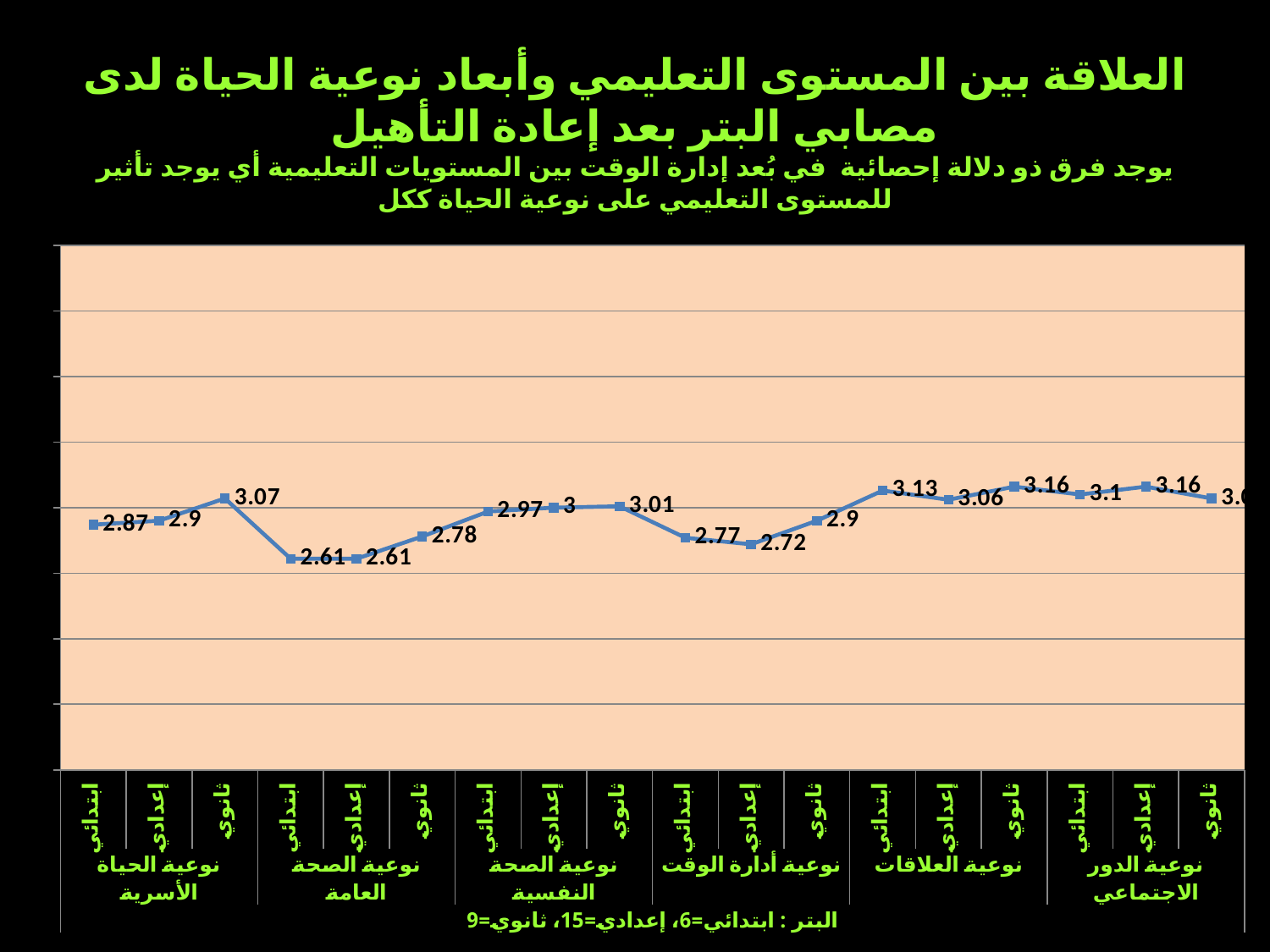
What is the value for ثانوي in the نوعية الحياة الأسرية group? 3.07 Which education level has the lowest value in the نوعية أدارة الوقت group? إعدادي What kind of chart is shown on the slide? line chart How many data points are plotted on the line? 18 What is the value for ابتدائي in the نوعية الصحة العامة group? 2.61 What is the value for ابتدائي in the نوعية العلاقات group? 3.13 Do the values rise or fall from ابتدائي to ثانوي within the نوعية الصحة النفسية group? rise What is the value for إعدادي in the نوعية الصحة النفسية group? 3 What is the difference between the ثانوي value and the ابتدائي value in the نوعية الصحة العامة group? 0.17 What is the value for إعدادي in the نوعية أدارة الوقت group? 2.72 Which is larger: the ابتدائي value in نوعية الحياة الأسرية or the ابتدائي value in نوعية الصحة العامة? نوعية الحياة الأسرية Which education level has the highest value in the نوعية الحياة الأسرية group? ثانوي